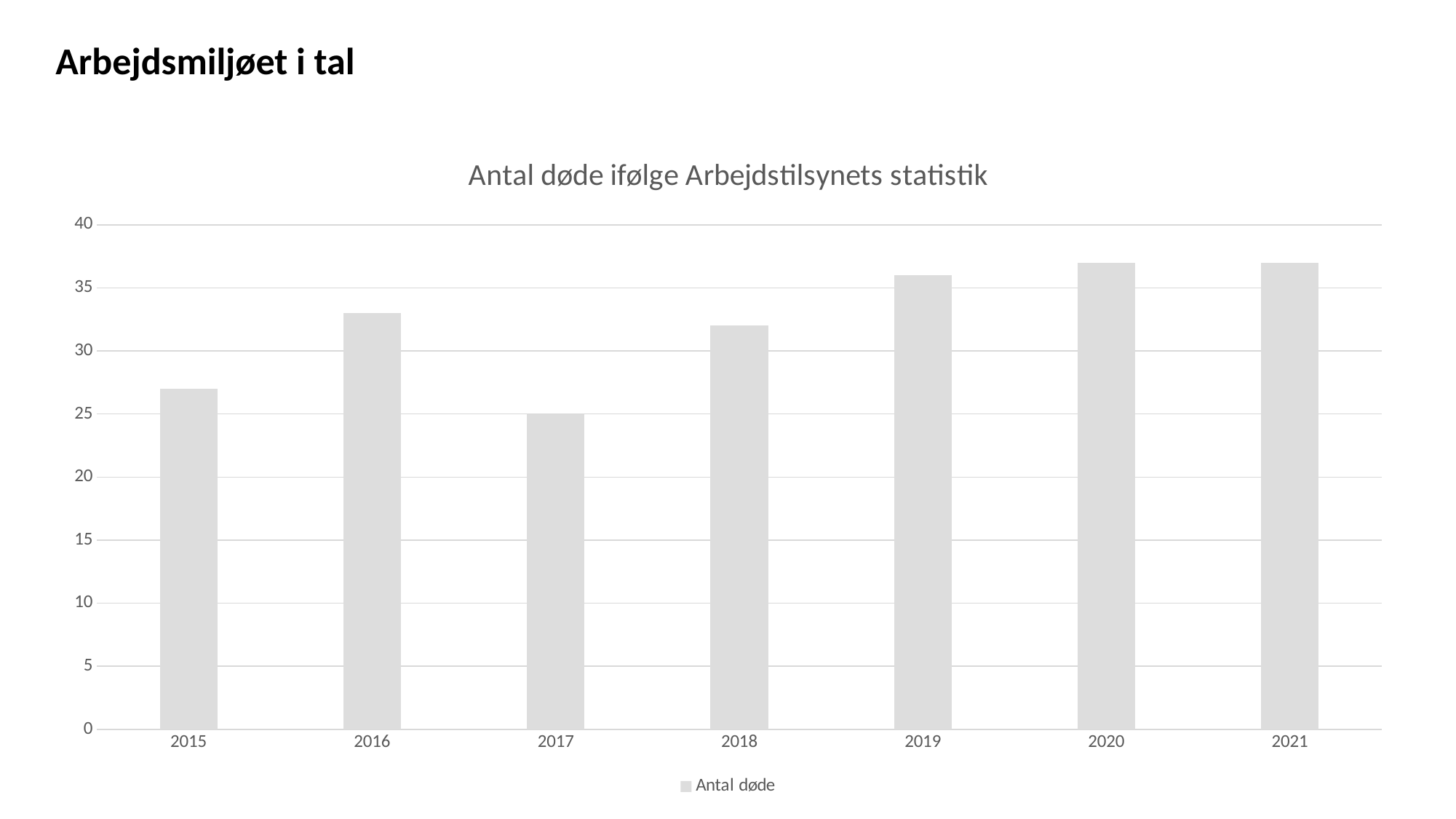
Is the value for 2015 greater or less than 30? less What is the series name shown in the legend? Antal døde Which is larger, the value for 2018 or the value for 2019? 2019 How many series does the legend list? 1 Do the values rise or fall from 2017 to 2021? rise What is the value for 2017? 25 Which is larger, the value for 2015 or the value for 2016? 2016 What is the title of the chart? Antal døde ifølge Arbejdstilsynets statistik Which year has the lowest value? 2017 Is the value for 2020 greater or less than 35? greater What type of chart is shown on the slide? bar chart How many years are shown on the x axis of the chart? 7